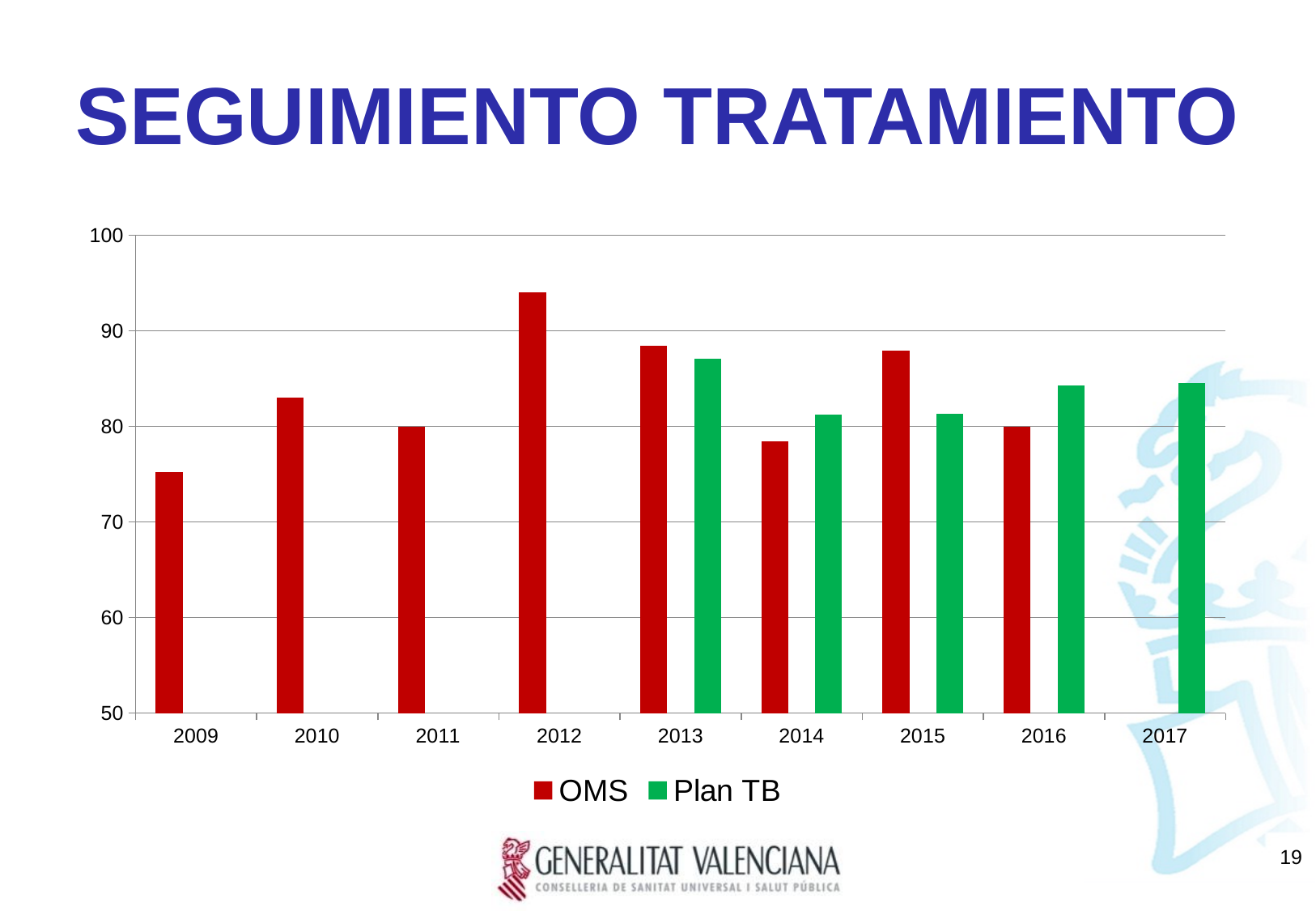
In 2016, which is larger, the OMS value or the Plan TB value? Plan TB In which year is the Plan TB value highest? 2013 Is the Plan TB value for 2016 greater or less than 80? greater How many years are shown on the x axis? 9 In which year is the OMS value highest? 2012 In which year is the OMS value lowest? 2009 Is the OMS value for 2012 greater or less than 90? greater What kind of chart is shown on the slide? bar chart How many series does the legend list? 2 Is the OMS value for 2009 greater or less than 80? less In 2015, which is larger, the OMS value or the Plan TB value? OMS Which colour represents the Plan TB series in the legend? green